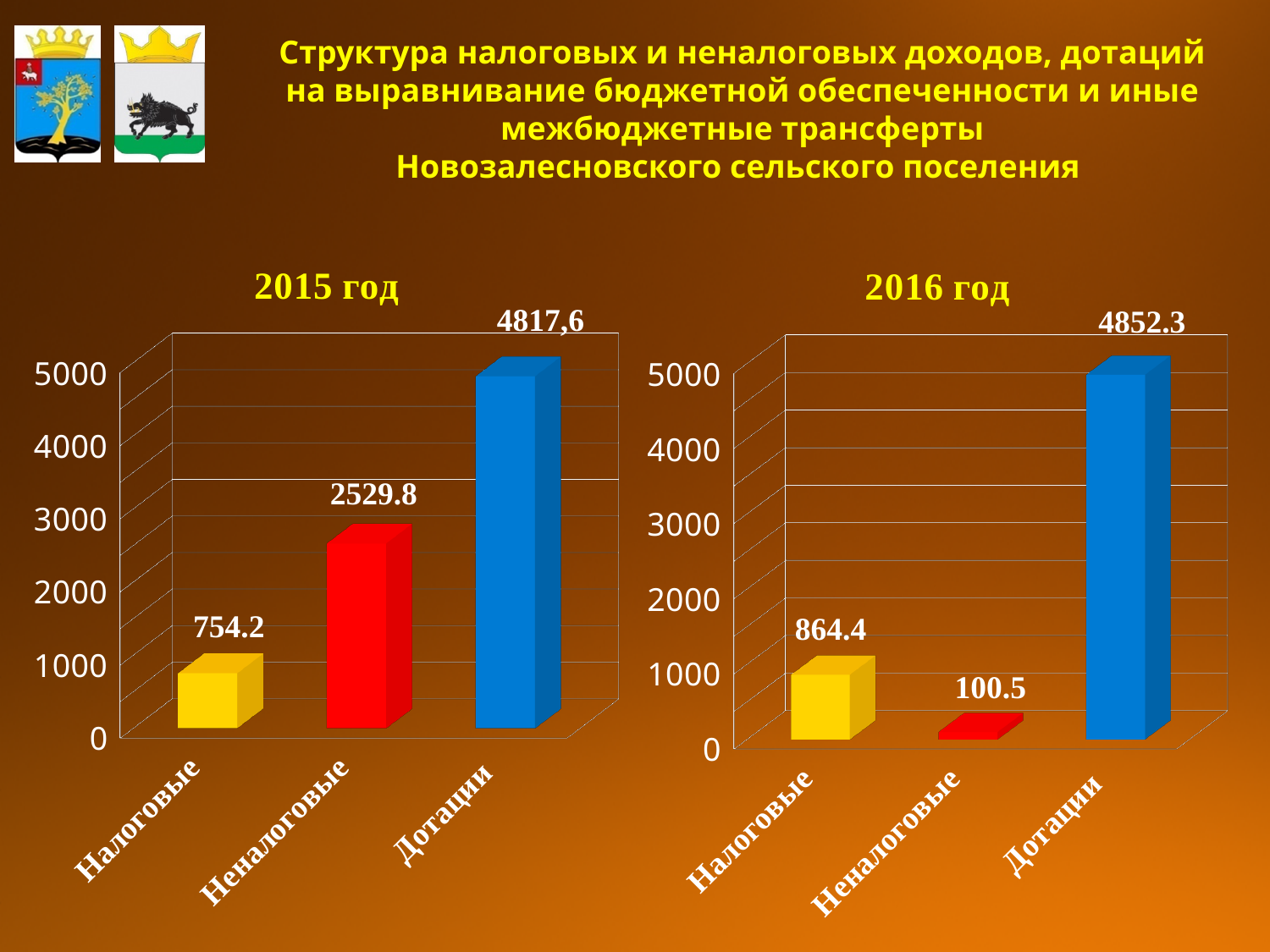
In the "2015 год" chart, what is the value for Налоговые? 754.2 In the "2016 год" chart, what is the difference between Налоговые and Неналоговые? 763.9 How many categories are shown in the "2016 год" chart? 3 In the "2015 год" chart, which category has the highest value? Дотации In the "2015 год" chart, what is the value for Дотации? 4817,6 In the "2016 год" chart, what is the value for Дотации? 4852.3 In the "2016 год" chart, what is the value for Неналоговые? 100.5 In the "2015 год" chart, what is the value for Неналоговые? 2529.8 In the "2015 год" chart, what is the difference between Неналоговые and Налоговые? 1775.6 In the "2016 год" chart, which category has the lowest value? Неналоговые What type of chart is the "2015 год" chart? Bar chart Which is larger: Налоговые in the "2015 год" chart or Налоговые in the "2016 год" chart? 2016 год